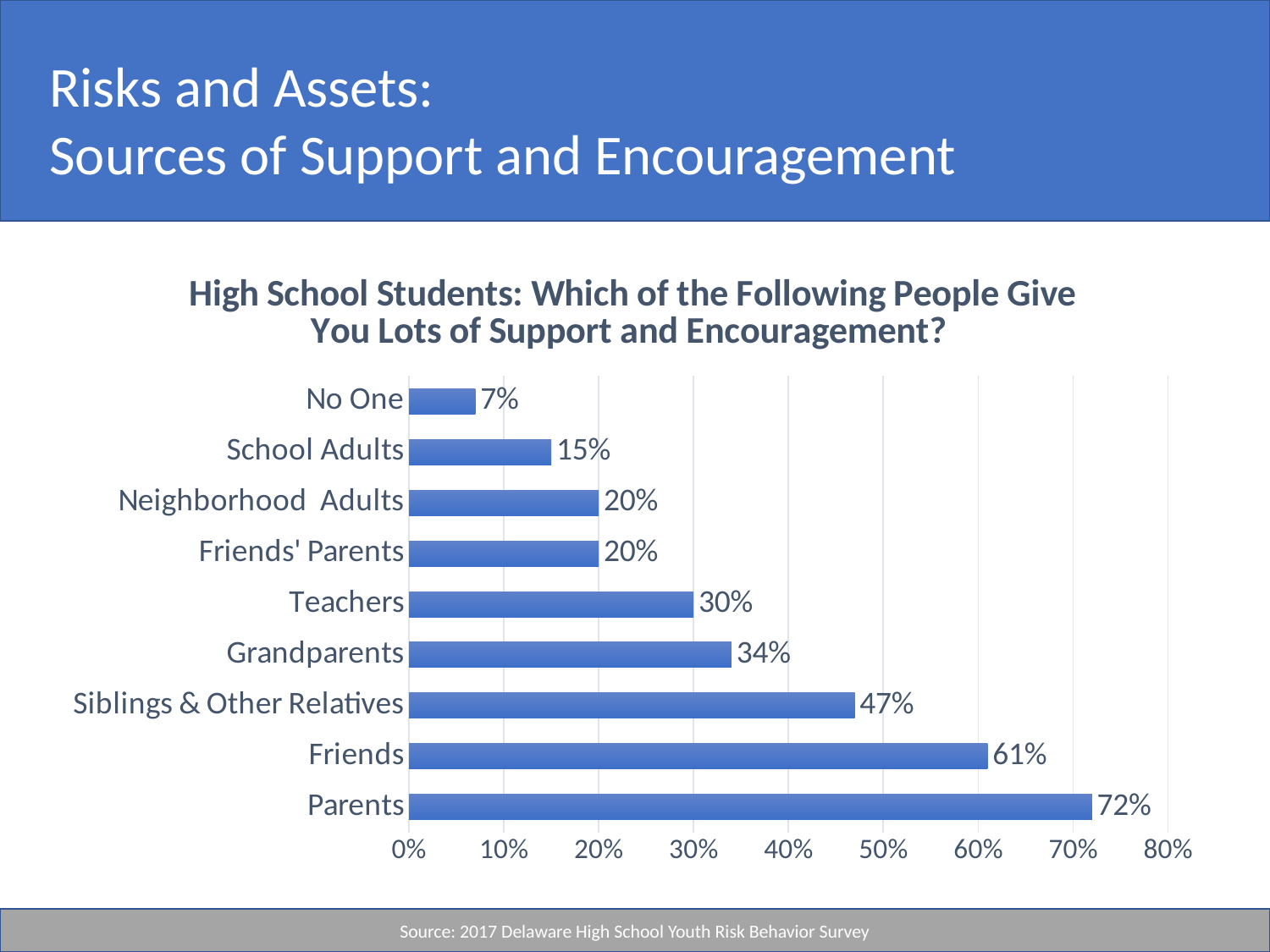
What is the difference between the values for Friends and Siblings & Other Relatives? 14% Which category has the highest value? Parents Which category has the lowest value? No One What kind of chart is shown on the slide? Bar chart How many categories are shown in the chart? 9 What is the source cited at the bottom of the slide? 2017 Delaware High School Youth Risk Behavior Survey What is the value shown for School Adults? 15% Is the value for Friends greater or less than 50%? greater What percentage of high school students said Parents give them lots of support and encouragement? 72% What is the difference between the values for Parents and Teachers? 42% What is the value shown for Grandparents? 34% Which is larger, the value for Teachers or the value for Grandparents? Grandparents